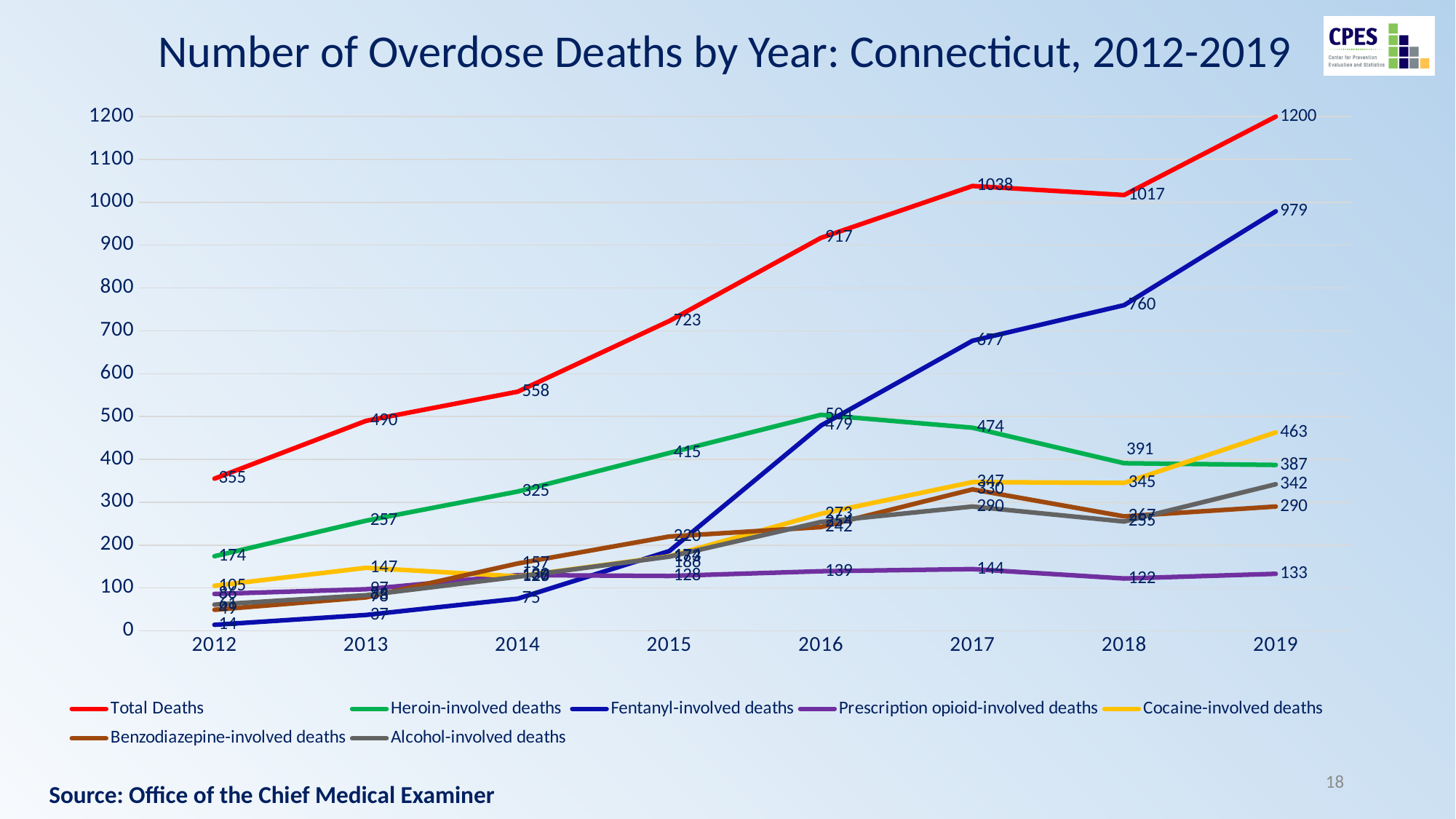
In which year were Total Deaths lowest? 2012 What was the number of Total Deaths in 2019? 1200 What is the difference between Fentanyl-involved deaths in 2019 and 2018? 219 How many years are shown on the x axis? 8 How many Fentanyl-involved deaths were there in 2019? 979 In 2019, which was larger: Heroin-involved deaths or Cocaine-involved deaths? Cocaine-involved deaths How many series does the legend list? 7 By how much did Total Deaths increase from 2018 to 2019? 183 What kind of chart is shown on the slide? Line chart How many Prescription opioid-involved deaths were there in 2017? 144 Is the value for Prescription opioid-involved deaths in 2014 greater or less than 200? less In which year were Heroin-involved deaths highest? 2016